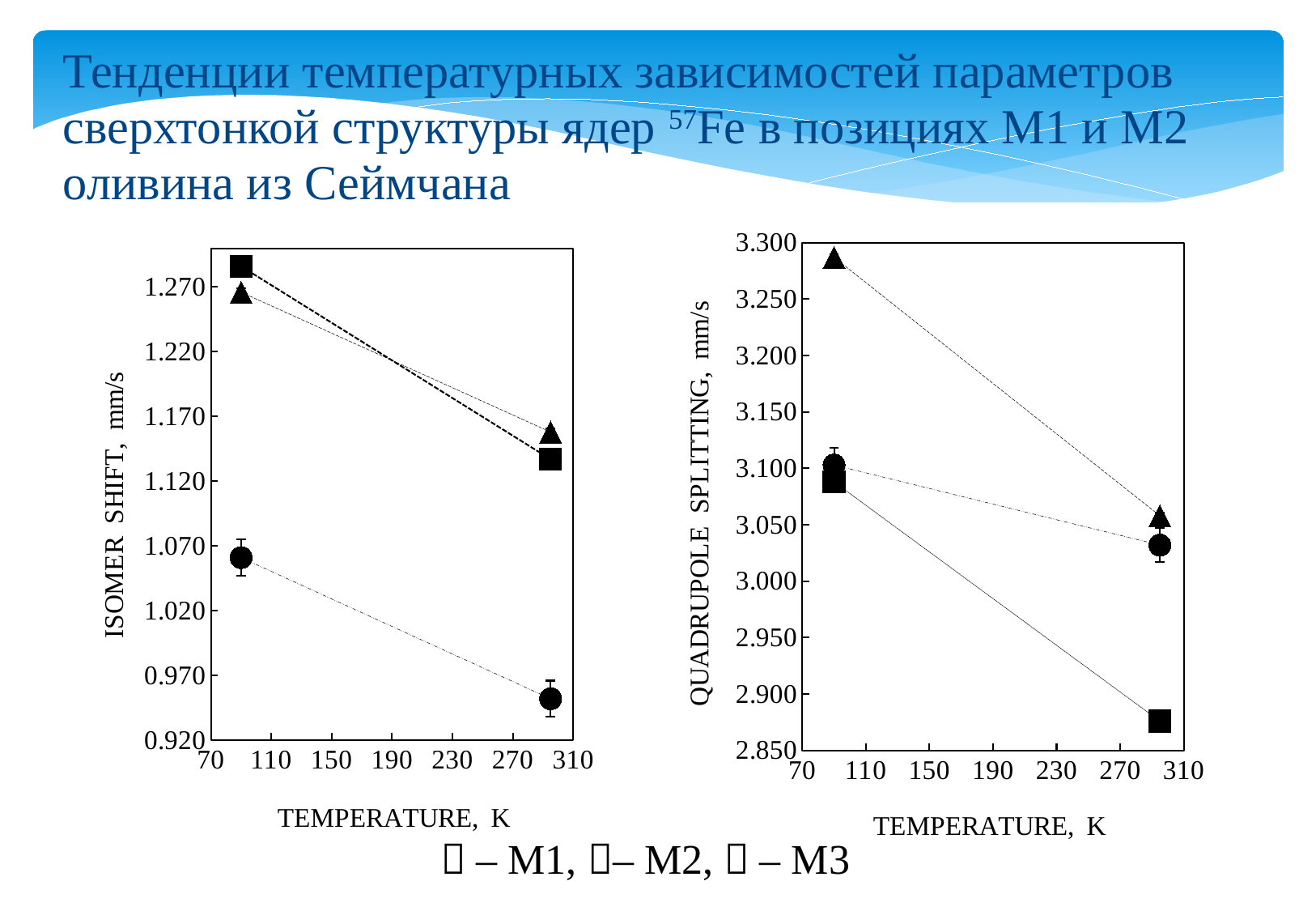
In the left chart (ISOMER SHIFT), is the value of the circle-marker series at its lower-temperature point (near 90 K) greater or less than 1.020? greater In the right chart (QUADRUPOLE SPLITTING), is the value of the square-marker series at its higher-temperature point (between 270 and 310 K) greater or less than 2.900? less In the left chart (ISOMER SHIFT), is the value of the circle-marker series at its higher-temperature point (between 270 and 310 K) greater or less than 0.970? less In the right chart (QUADRUPOLE SPLITTING), does the square-marker series rise or fall as temperature increases? fall What is the y-axis label of the right chart? QUADRUPOLE SPLITTING, mm/s How many temperature points are plotted for each series in the left chart (ISOMER SHIFT)? 2 In the right chart (QUADRUPOLE SPLITTING), which series has the lowest plotted point? square-marker series What kind of chart is the left chart (ISOMER SHIFT vs TEMPERATURE)? scatter chart with connected points In the left chart (ISOMER SHIFT), at the higher-temperature point (between 270 and 310 K), which is larger: the triangle-marker series or the circle-marker series? triangle-marker series How many marker series are plotted in the right chart (QUADRUPOLE SPLITTING)? 3 In the left chart (ISOMER SHIFT), does the circle-marker series rise or fall as temperature increases? fall